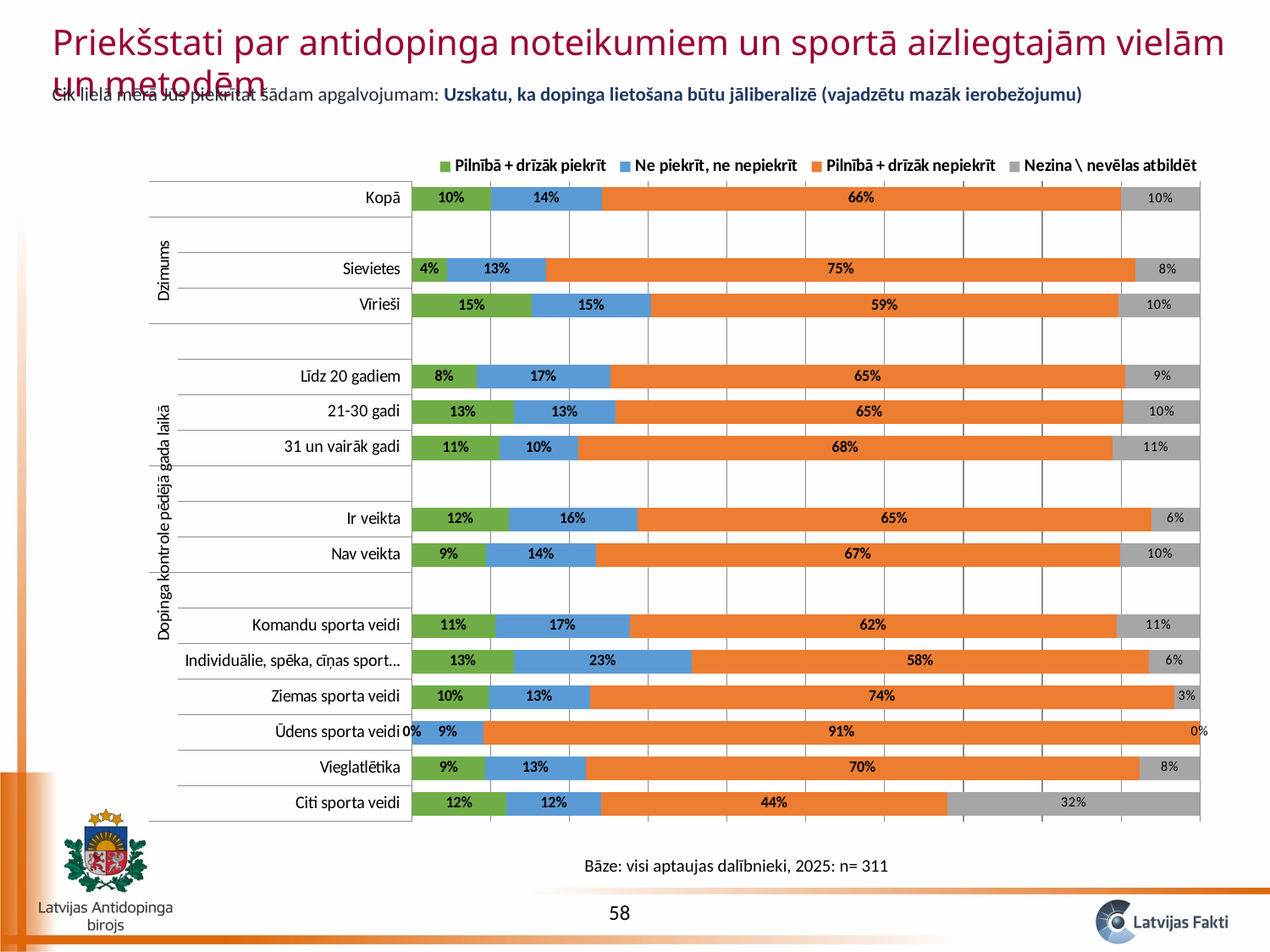
Which has a larger "Ne piekrīt, ne nepiekrīt" value: Komandu sporta veidi or Ziemas sporta veidi? Komandu sporta veidi What kind of chart is shown on the slide? Stacked bar chart What is the value of "Pilnībā + drīzāk nepiekrīt" for Kopā? 66% Which category has the lowest value for "Pilnībā + drīzāk nepiekrīt"? Citi sporta veidi Which category has the highest value for "Pilnībā + drīzāk nepiekrīt"? Ūdens sporta veidi What is the value of "Pilnībā + drīzāk piekrīt" for Vīrieši? 15% What is the value of "Pilnībā + drīzāk piekrīt" for Sievietes? 4% What is the difference between the "Pilnībā + drīzāk nepiekrīt" values for Sievietes and Vīrieši? 16 percentage points What is the value of "Ne piekrīt, ne nepiekrīt" for Individuālie, spēka, cīņas sport...? 23% How many series does the legend list? 4 How many categories (bars) are shown in the chart? 14 What is the value of "Nezina \ nevēlas atbildēt" for Citi sporta veidi? 32%